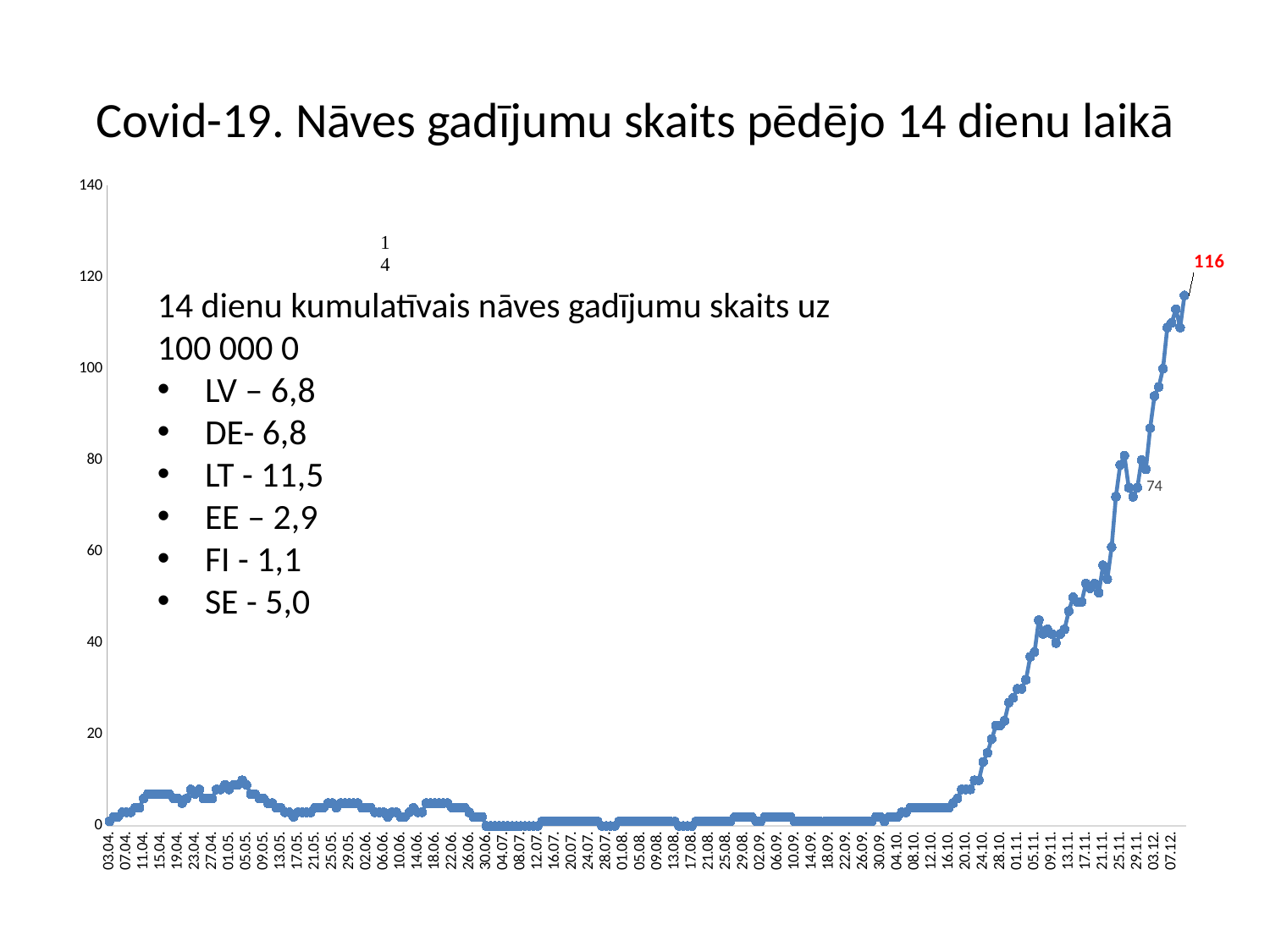
What value is labelled on the chart near the dip at the end of November / start of December? 74 Is the value for 16.10. greater or less than 20? less Which labelled value is larger, 116 or 74? 116 Is the value for 25.11. greater or less than 60? greater What is the value of the last data point on the chart, labelled in red? 116 What is the title of the chart? Covid-19. Nāves gadījumu skaits pēdējo 14 dienu laikā Is the value for 04.07. greater or less than 20? less What is the difference between the labelled values 116 and 74? 42 What is the maximum value shown on the vertical axis? 140 Do the values rise or fall along the x axis from October to December? rise What is the highest value labelled on the chart? 116 What kind of chart is shown on the slide? line chart